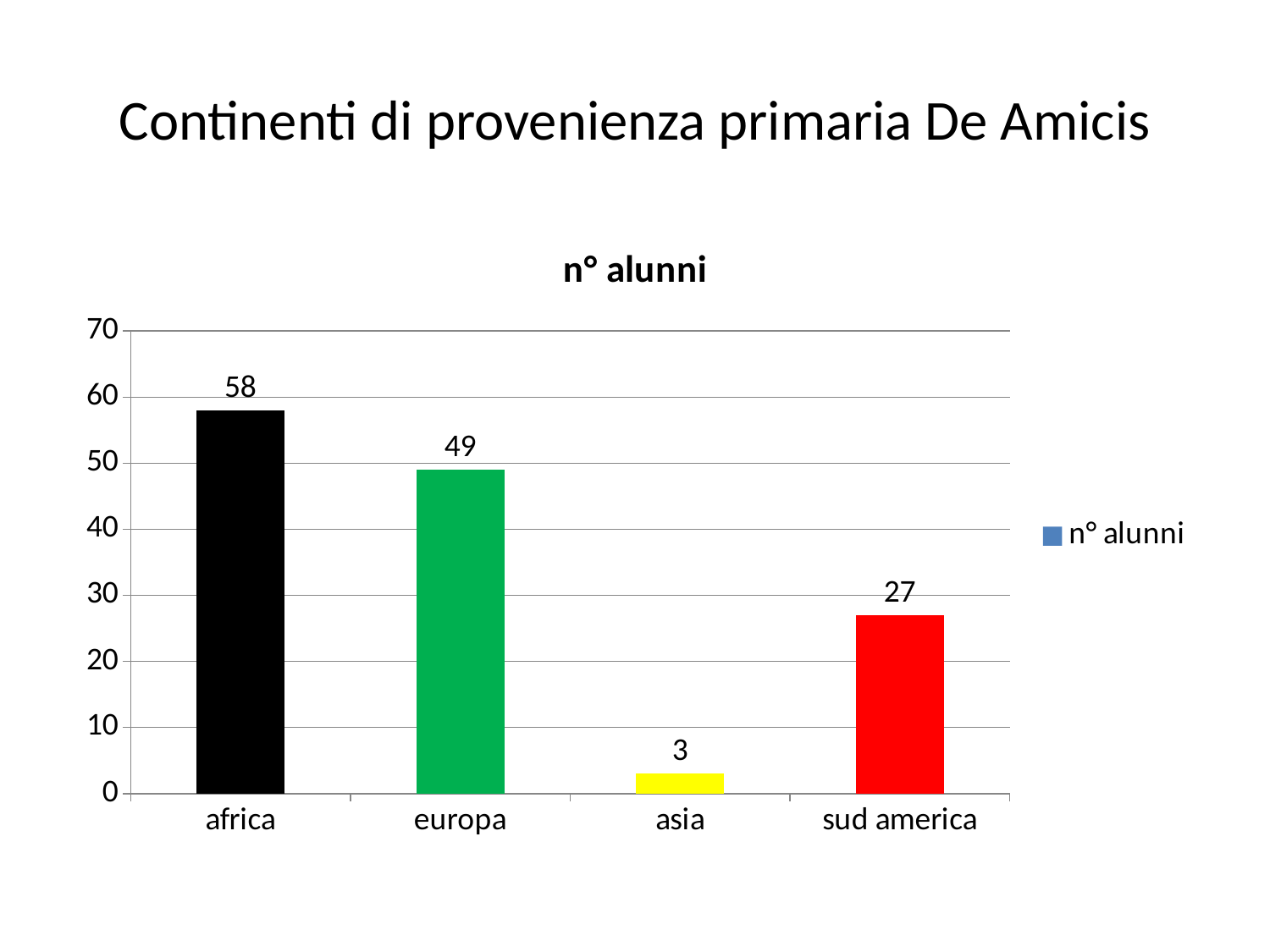
What is the difference between the values for europa and sud america? 22 What is the difference between the values for africa and europa? 9 How many categories are shown on the x axis? 4 What is the value for africa? 58 What is the value for sud america? 27 What is the value for europa? 49 What is the value for asia? 3 Which is larger, the value for sud america or the value for asia? sud america What kind of chart is shown on the slide? bar chart Which category has the highest value? africa What is the title of the chart? n° alunni Which category has the lowest value? asia